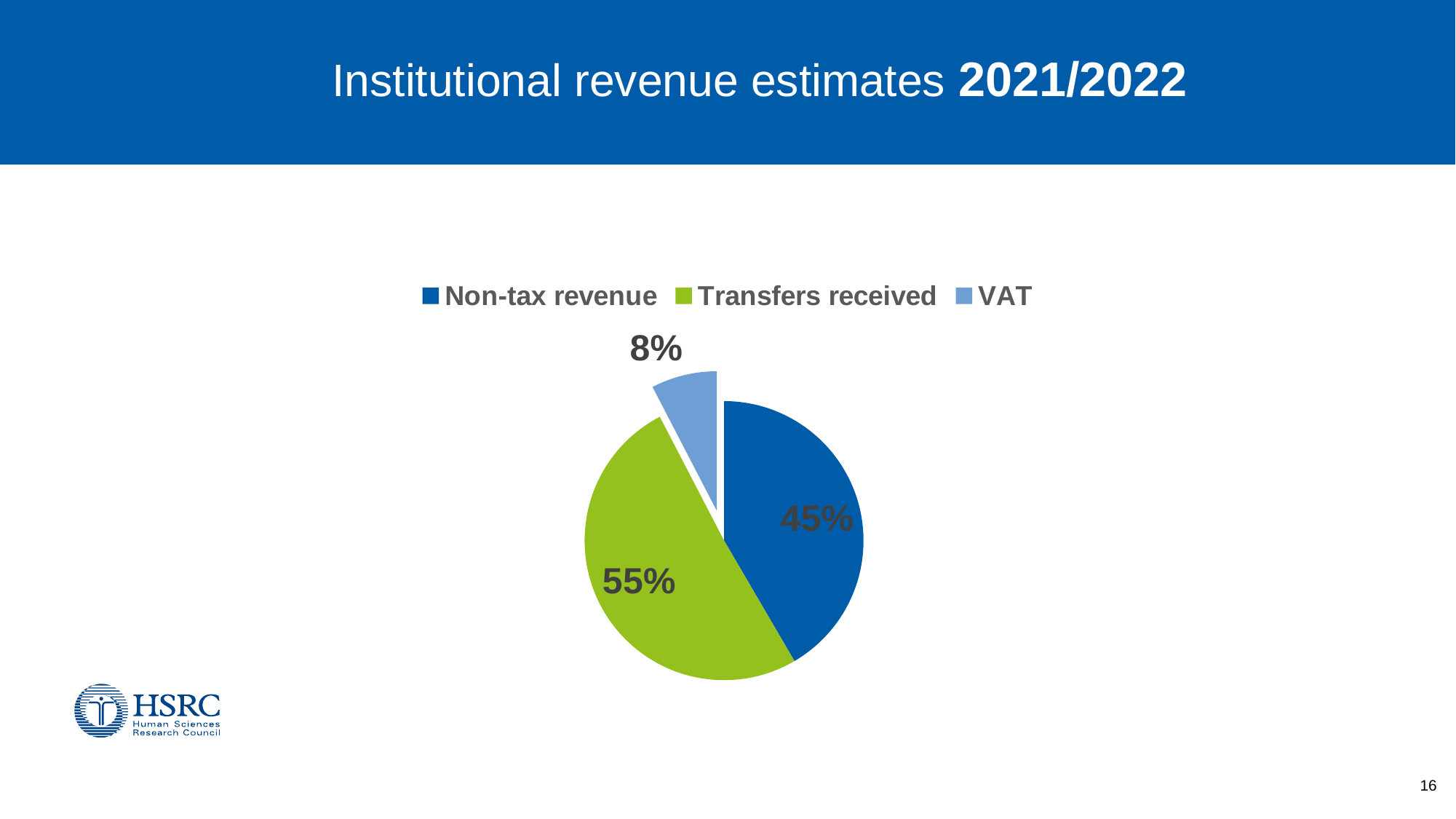
What colour is the Transfers received slice? green What share of the pie does VAT represent? 8% Which category has the largest slice of the pie? Transfers received What share of the pie does Non-tax revenue represent? 45% What is the title of the slide containing the chart? Institutional revenue estimates 2021/2022 How many entries does the legend list? 3 How many slices does the pie chart have? 3 Which category has the smallest slice of the pie? VAT Which is larger, the share for Non-tax revenue or the share for VAT? Non-tax revenue What kind of chart is shown on the slide? pie chart What is the difference between the Transfers received share and the Non-tax revenue share? 10% What share of the pie does Transfers received represent? 55%